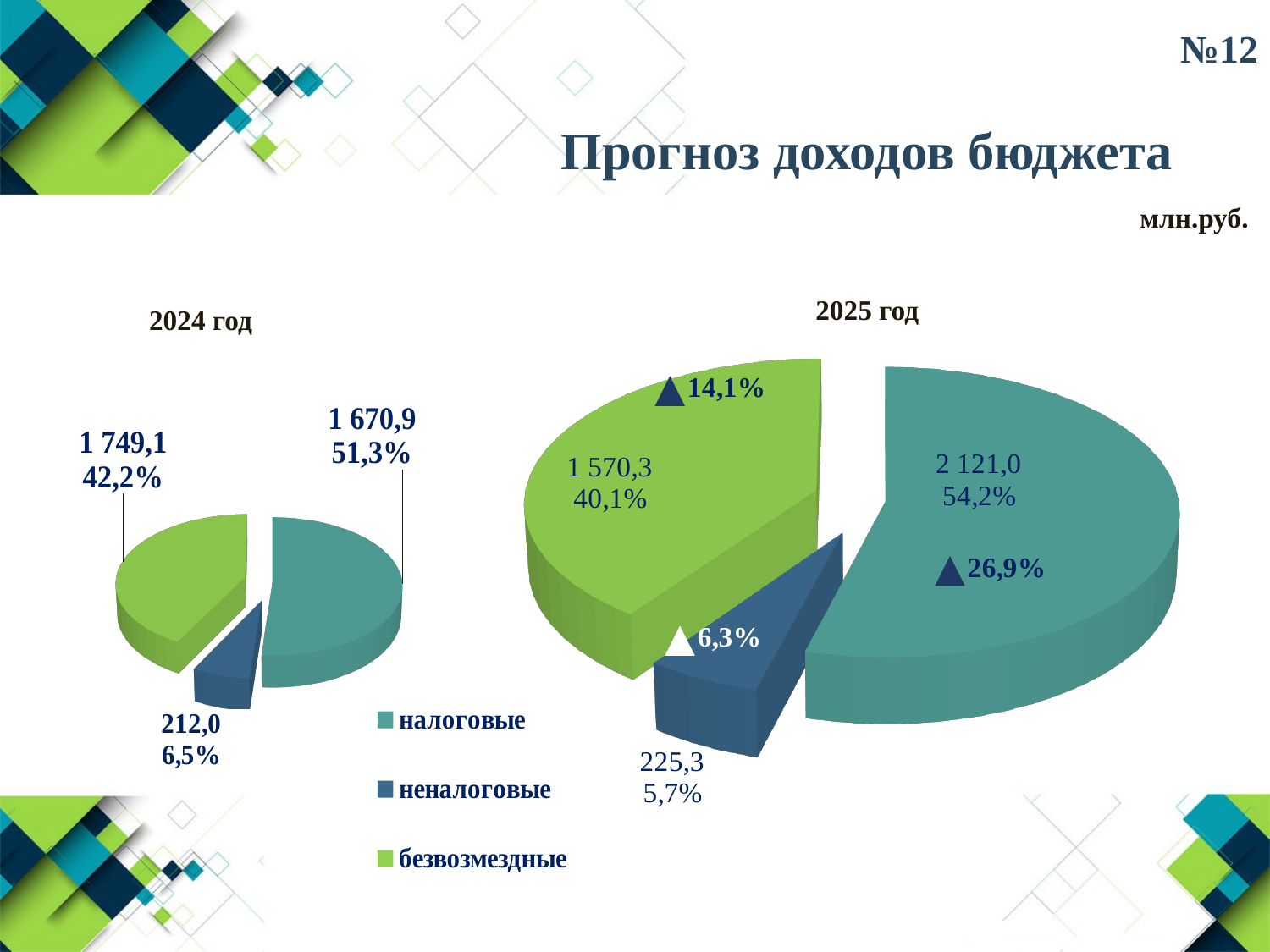
In the 2025 год pie chart, which category has the largest slice? налоговые In the 2025 год pie chart, what share is shown for безвозмездные? 40,1% In the 2024 год pie chart, which category has the smallest slice? неналоговые What colour represents безвозмездные in the legend? green What type of chart is used for 2025 год? pie chart In the 2024 год pie chart, what is the value for безвозмездные? 1 749,1 How many slices does the 2024 год pie chart have? 3 How many categories does the legend list? 3 Is the value for неналоговые larger in the 2024 год chart or the 2025 год chart? 2025 год In the 2025 год pie chart, what is the difference between the values for налоговые and безвозмездные? 550,7 In the 2024 год pie chart, what share is shown for неналоговые? 6,5% In the 2025 год pie chart, what is the value for налоговые? 2 121,0